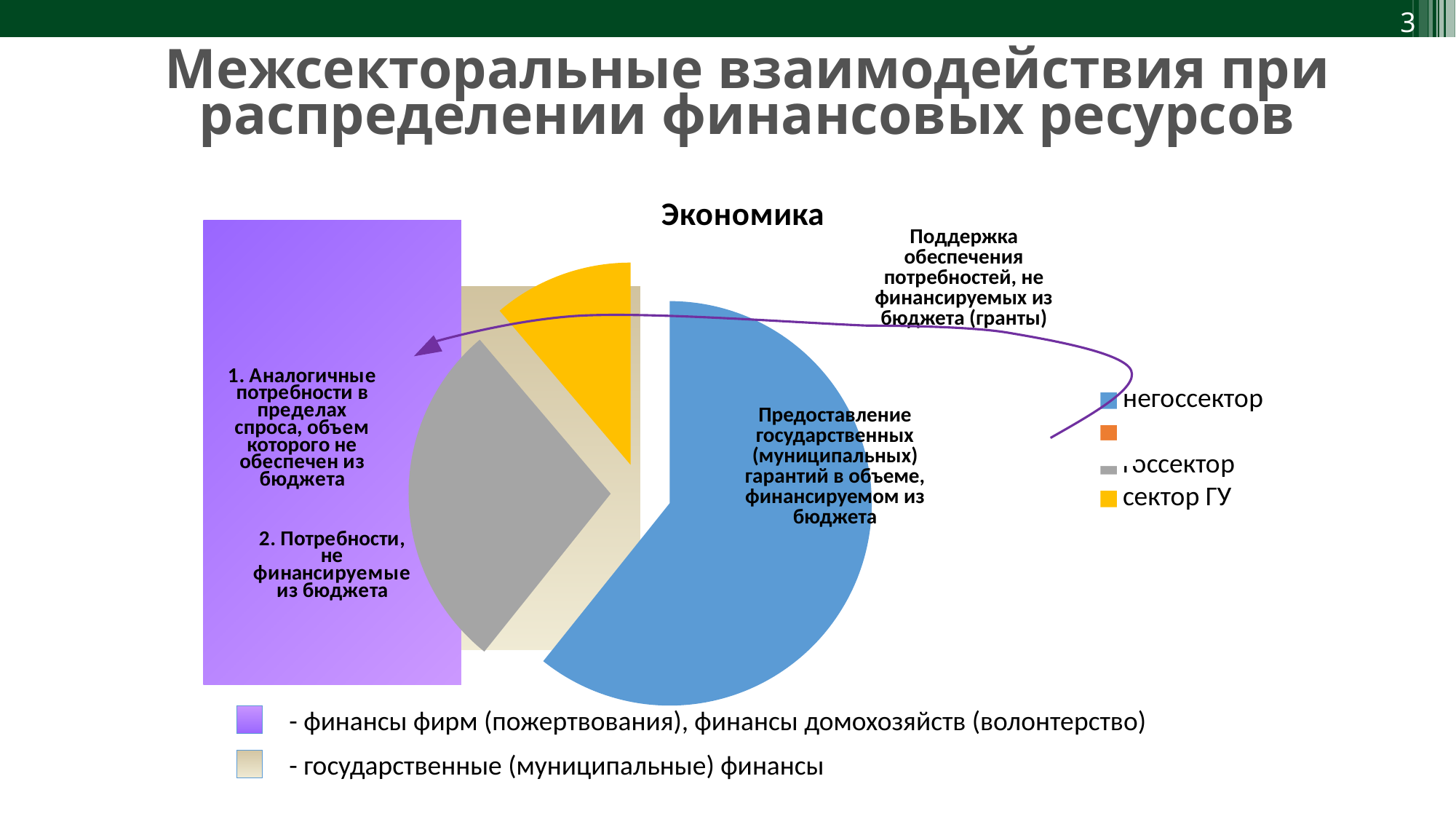
What kind of chart is shown under the heading "Экономика"? pie chart What colour is the негоссектор slice in the pie chart? blue Which slice is larger in the pie chart, негоссектор or сектор ГУ? негоссектор How many data series does the pie chart plot? 1 Which category has the largest slice in the pie chart? негоссектор How many entries does the legend of the pie chart list? 4 What is the title of the pie chart? Экономика Which slice is larger in the pie chart, госсектор or негоссектор? негоссектор